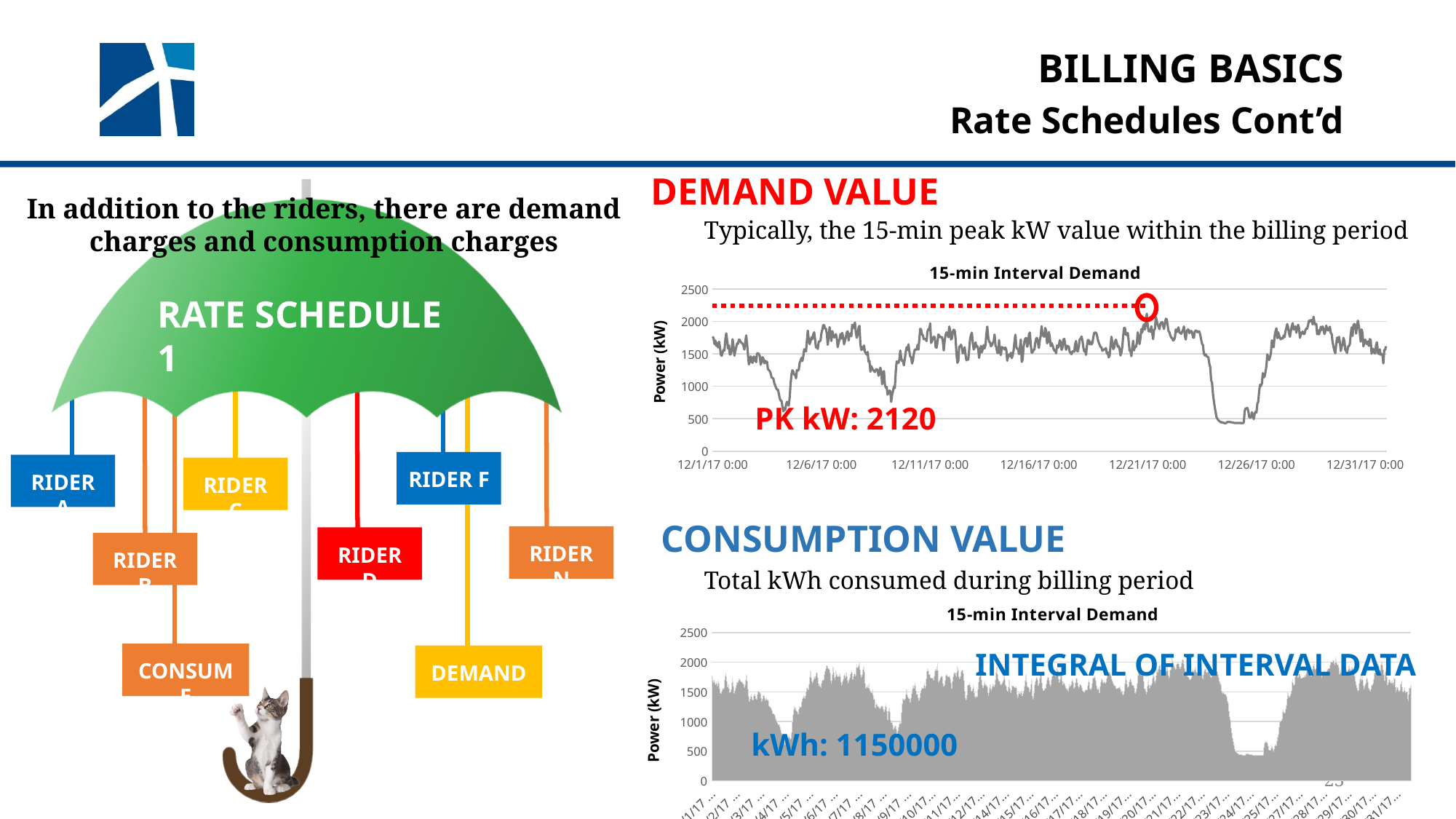
What is the first date label on the x-axis of the top chart under DEMAND VALUE? 12/1/17 0:00 In the top chart under DEMAND VALUE, is the value at 12/26/17 0:00 greater or less than 1000? less In the top chart under DEMAND VALUE, is the value at 12/1/17 0:00 greater or less than 1000? greater What kind of chart is the bottom chart titled '15-min Interval Demand' under CONSUMPTION VALUE? area chart What is the y-axis label of the top chart under DEMAND VALUE? Power (kW) What is the highest tick value shown on the y-axis of the top chart under DEMAND VALUE? 2500 In the top chart under DEMAND VALUE, is the annotated peak kW value greater or less than 2000? greater What is the title of the bottom chart under CONSUMPTION VALUE? 15-min Interval Demand What kind of chart is the top chart titled '15-min Interval Demand' under DEMAND VALUE? line chart In the top chart under DEMAND VALUE, what peak kW value is annotated on the chart? 2120 In the bottom chart under CONSUMPTION VALUE, what kWh value is annotated on the chart? 1150000